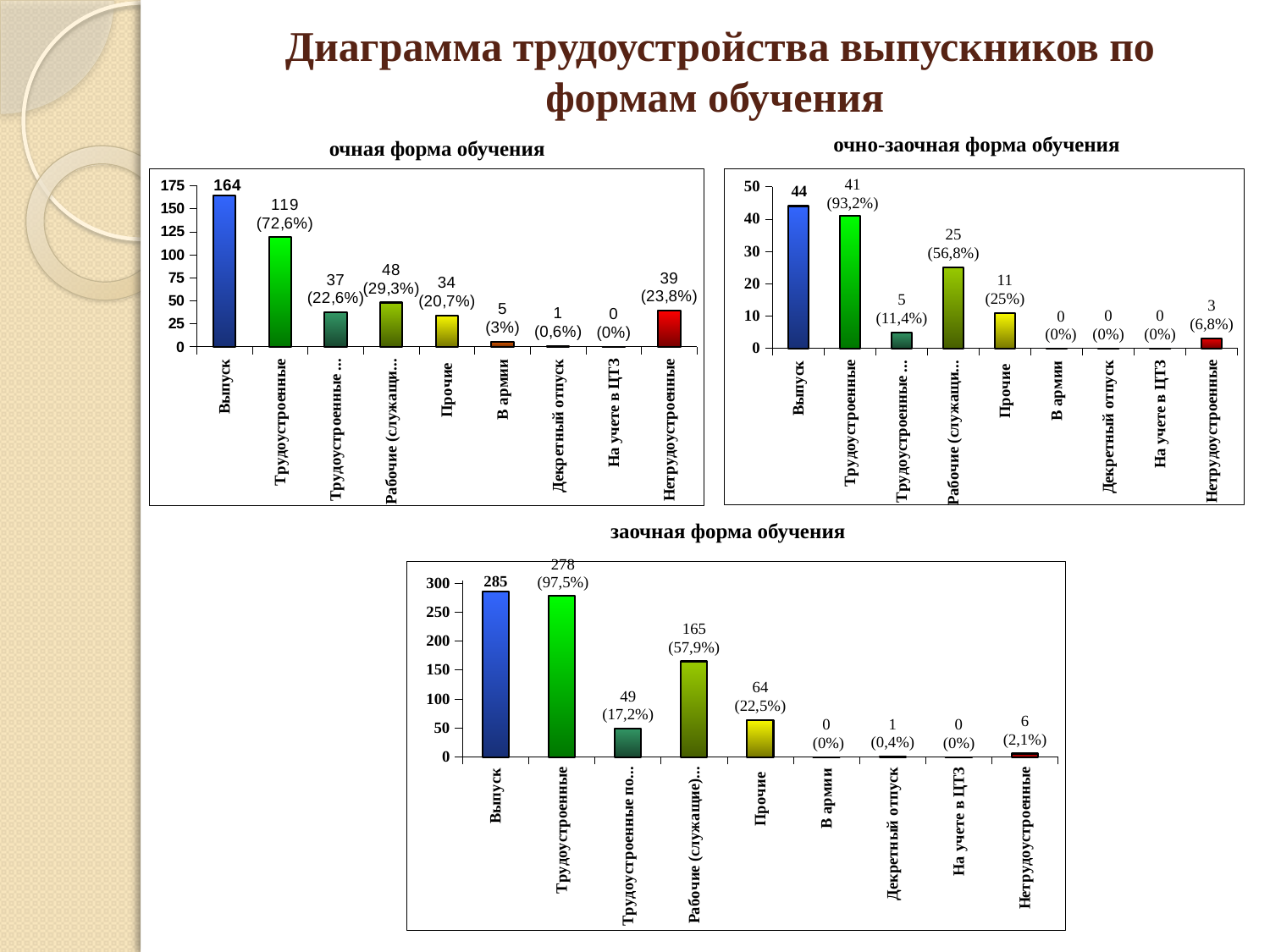
In the chart titled "очно-заочная форма обучения", what is the value for Прочие? 11 In the chart titled "заочная форма обучения", which is larger, the value for Прочие or the value for Трудоустроенные по...? Прочие In the chart titled "очно-заочная форма обучения", what percentage is shown for Нетрудоустроенные? 6,8% In the chart titled "очная форма обучения", what is the value for Выпуск? 164 In the chart titled "очная форма обучения", what is the value for Трудоустроенные? 119 In the chart titled "заочная форма обучения", what is the difference between the values for Выпуск and Трудоустроенные? 7 In the chart titled "очная форма обучения", which category has the lowest value? На учете в ЦТЗ In the chart titled "очная форма обучения", what is the difference between the values for Выпуск and Трудоустроенные? 45 In the chart titled "очно-заочная форма обучения", which category has the highest value? Выпуск How many categories are shown on the x axis of the chart titled "заочная форма обучения"? 9 What type of chart is the chart titled "очная форма обучения"? Bar chart In the chart titled "заочная форма обучения", what is the value for Рабочие (служащие)? 165